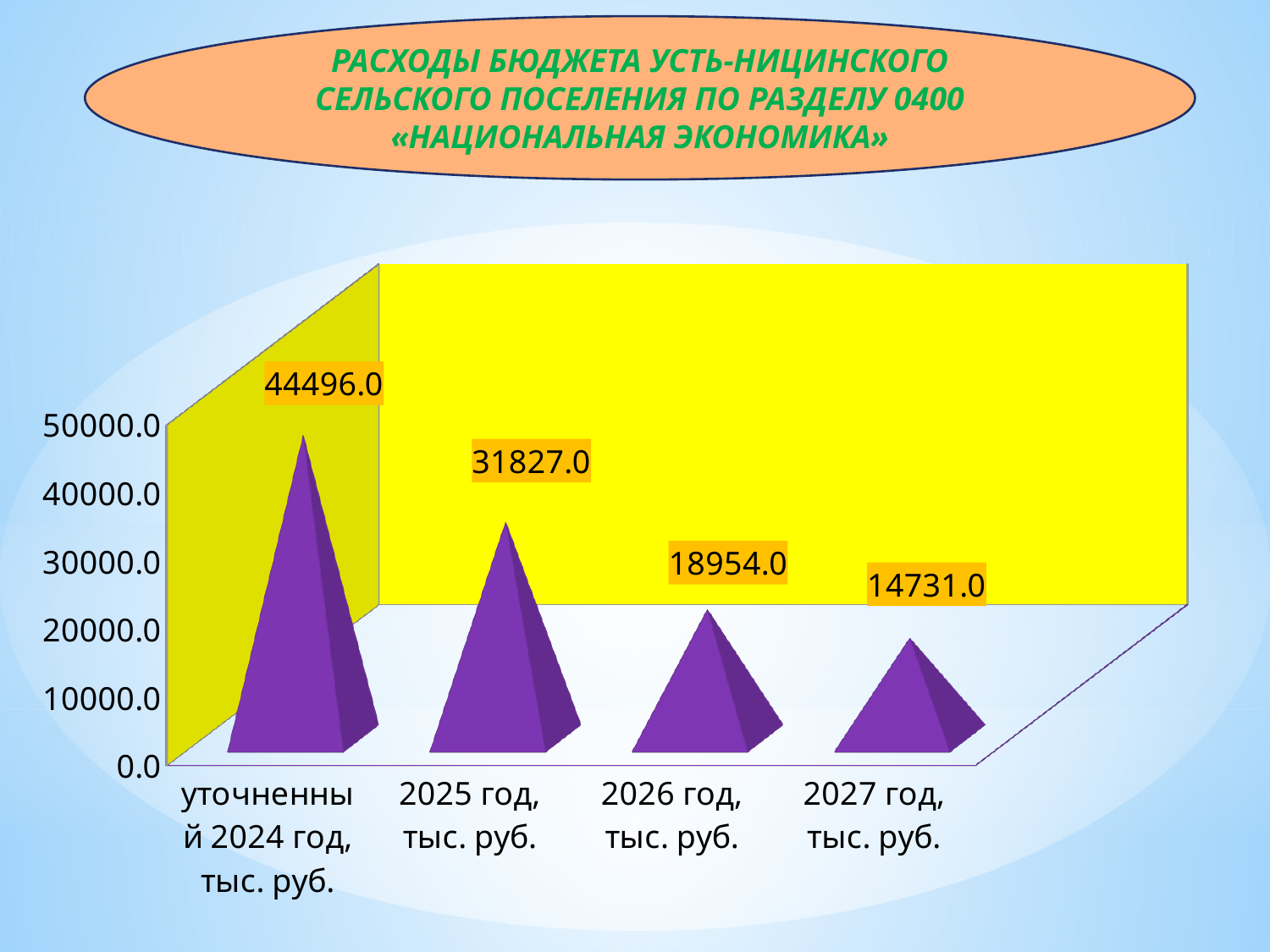
What is the value for 2027 год, тыс. руб.? 14731.0 What is the value for уточненный 2024 год, тыс. руб.? 44496.0 What kind of chart is shown on the slide? bar chart Which category has the lowest value? 2027 год, тыс. руб. What is the value for 2025 год, тыс. руб.? 31827.0 What is the difference between the values for 2025 год and 2026 год? 12873.0 Is the value for 2026 год, тыс. руб. greater or less than 20000.0? less What is the difference between the values for уточненный 2024 год and 2027 год? 29765.0 Do the values rise or fall from left to right along the x axis? fall How many categories are shown on the x axis? 4 Which category has the highest value? уточненный 2024 год, тыс. руб. Which is larger, the value for 2026 год or the value for 2027 год? 2026 год, тыс. руб.